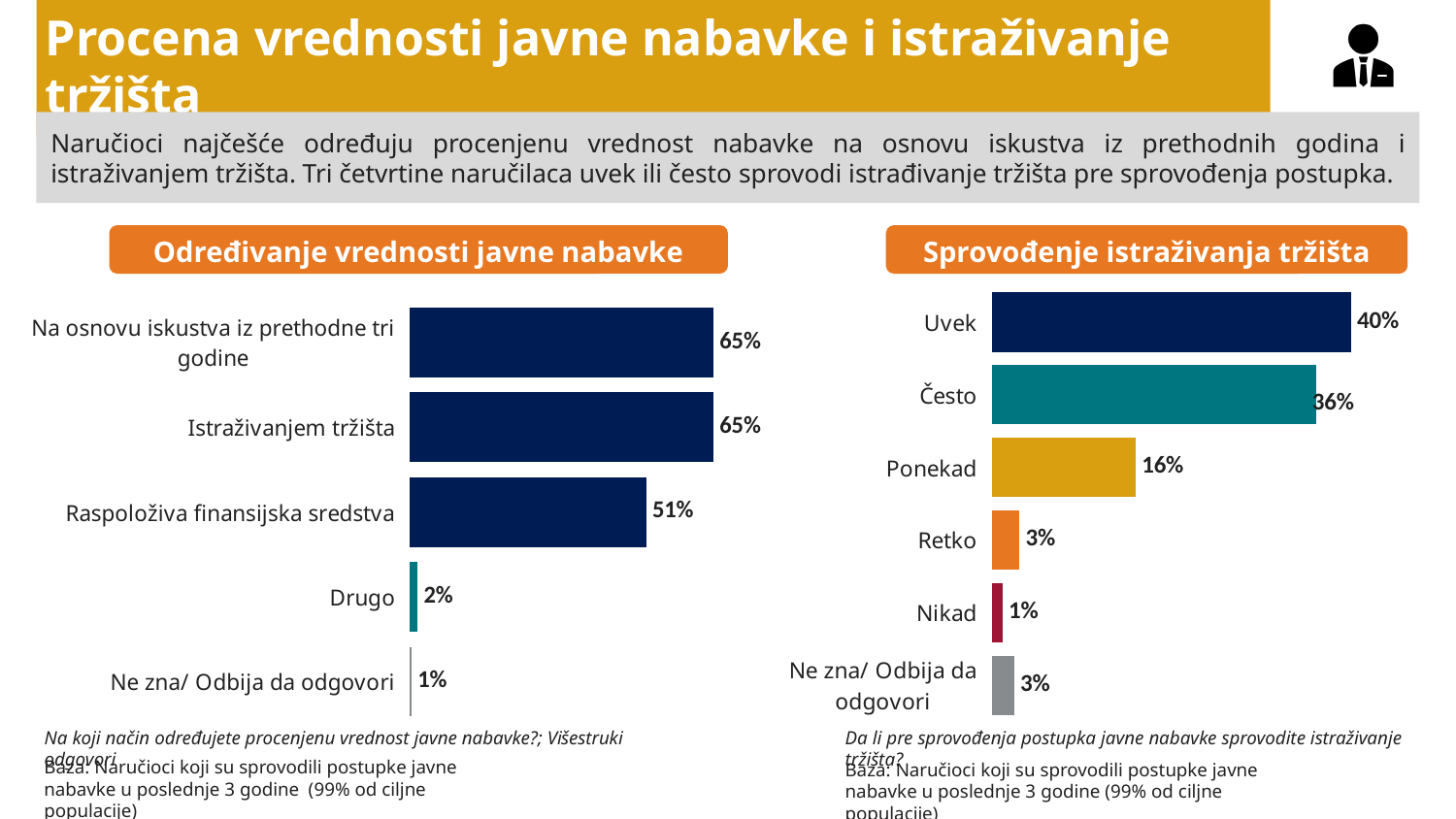
In the chart 'Određivanje vrednosti javne nabavke', what is the value for 'Istraživanjem tržišta'? 65% In the chart 'Određivanje vrednosti javne nabavke', which category has the lowest value? Ne zna/ Odbija da odgovori In the chart 'Određivanje vrednosti javne nabavke', what is the difference between 'Istraživanjem tržišta' and 'Raspoloživa finansijska sredstva'? 14% In the chart 'Sprovođenje istraživanja tržišta', what is the value for 'Ponekad'? 16% In the chart 'Određivanje vrednosti javne nabavke', what is the value for 'Drugo'? 2% In the chart 'Određivanje vrednosti javne nabavke', what is the value for 'Raspoloživa finansijska sredstva'? 51% In the chart 'Sprovođenje istraživanja tržišta', which category has the highest value? Uvek In the chart 'Sprovođenje istraživanja tržišta', what is the difference between 'Uvek' and 'Često'? 4% What type of chart is 'Sprovođenje istraživanja tržišta'? Bar chart In the chart 'Sprovođenje istraživanja tržišta', which is larger: 'Retko' or 'Nikad'? Retko In the chart 'Sprovođenje istraživanja tržišta', what is the value for 'Nikad'? 1% How many categories are shown in the chart 'Određivanje vrednosti javne nabavke'? 5